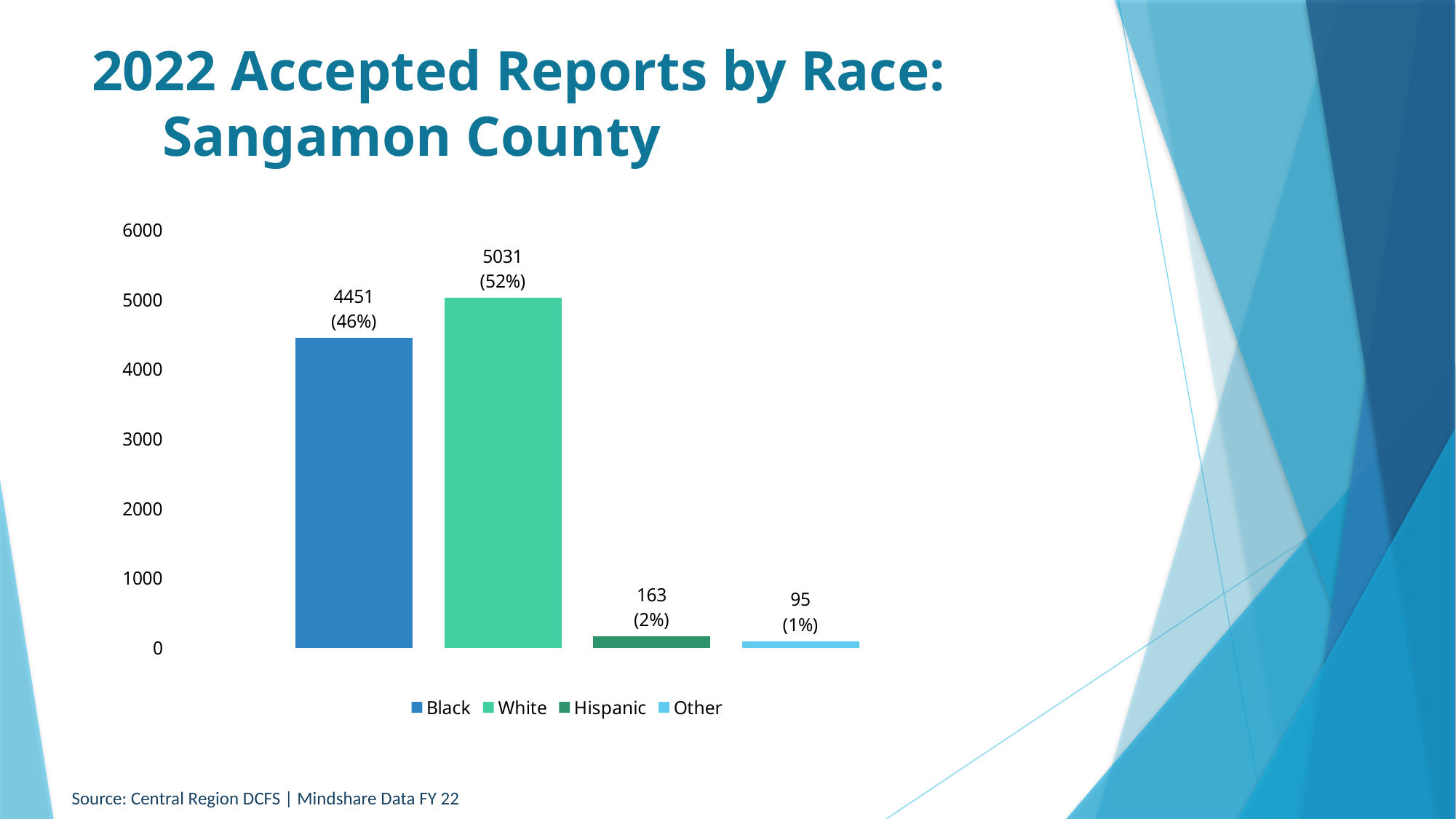
Which has more accepted reports, Hispanic or Other? Hispanic How many race categories are shown in the chart? 4 What is the difference between the White and Black accepted report counts? 580 What is the number of accepted reports for Hispanic? 163 Which race category has the lowest number of accepted reports? Other What kind of chart is shown on the slide? Bar chart Is the value for Black greater or less than 4000? greater What is the number of accepted reports for Black? 4451 Which race category has the highest number of accepted reports? White What is the source cited at the bottom of the slide? Central Region DCFS | Mindshare Data FY 22 What is the number of accepted reports for White? 5031 What percentage of accepted reports is labelled for Other? 1%